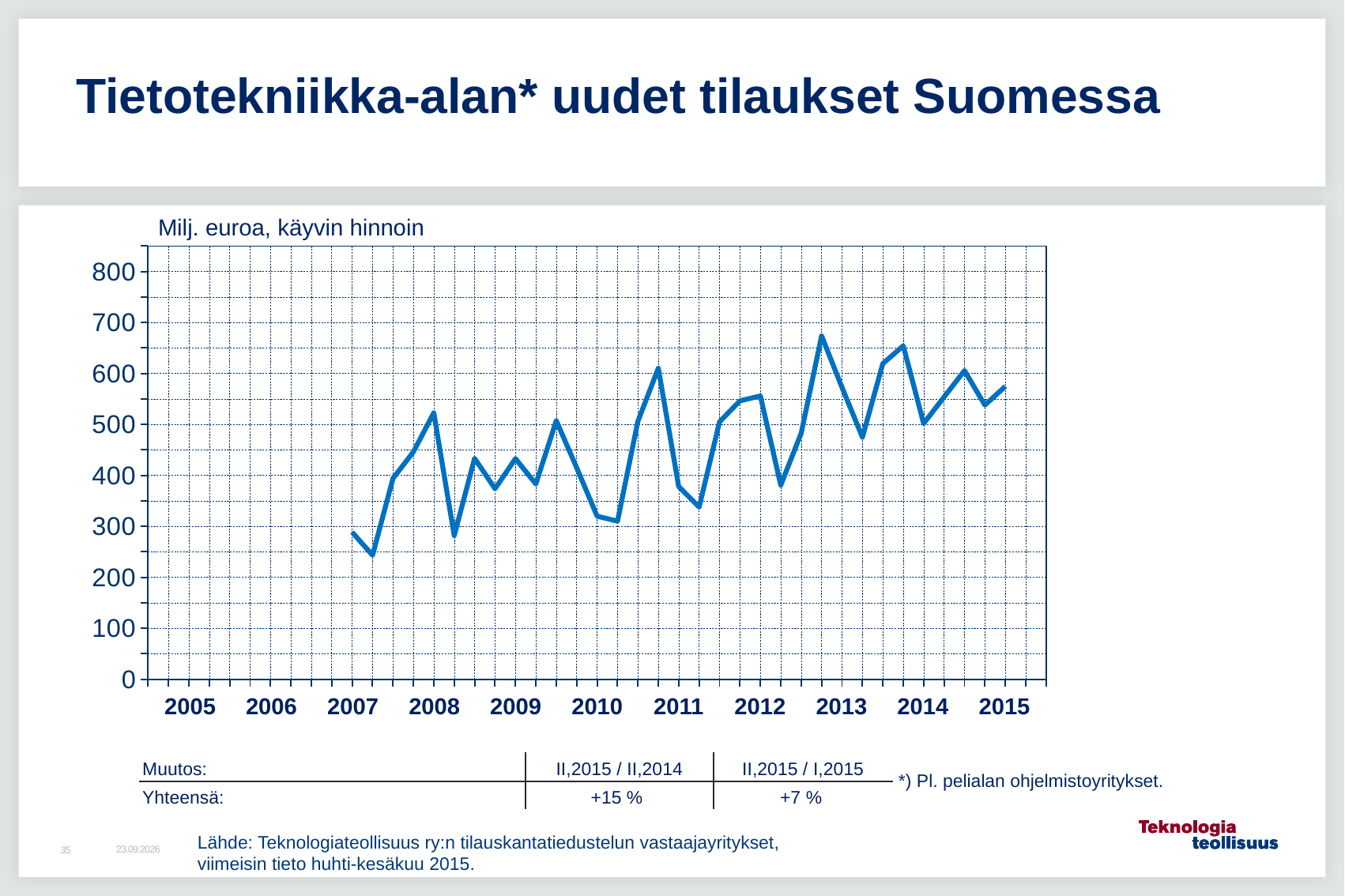
How many year labels are shown on the x axis of the chart? 11 How many lines are plotted on the chart? 1 What kind of chart is shown on the slide? line chart What is the title of the slide's chart? Tietotekniikka-alan* uudet tilaukset Suomessa In which year does the line reach its lowest point? 2007 Overall, do the values rise or fall from 2007 to 2015? rise Is the lowest value on the line greater or less than 300? less Is the last value on the line, in 2015, greater or less than 500? greater According to the table below the chart, what is the change for II,2015 / II,2014? +15 % Is the highest value on the line greater or less than 600? greater What unit label is printed above the y axis of the chart? Milj. euroa, käyvin hinnoin